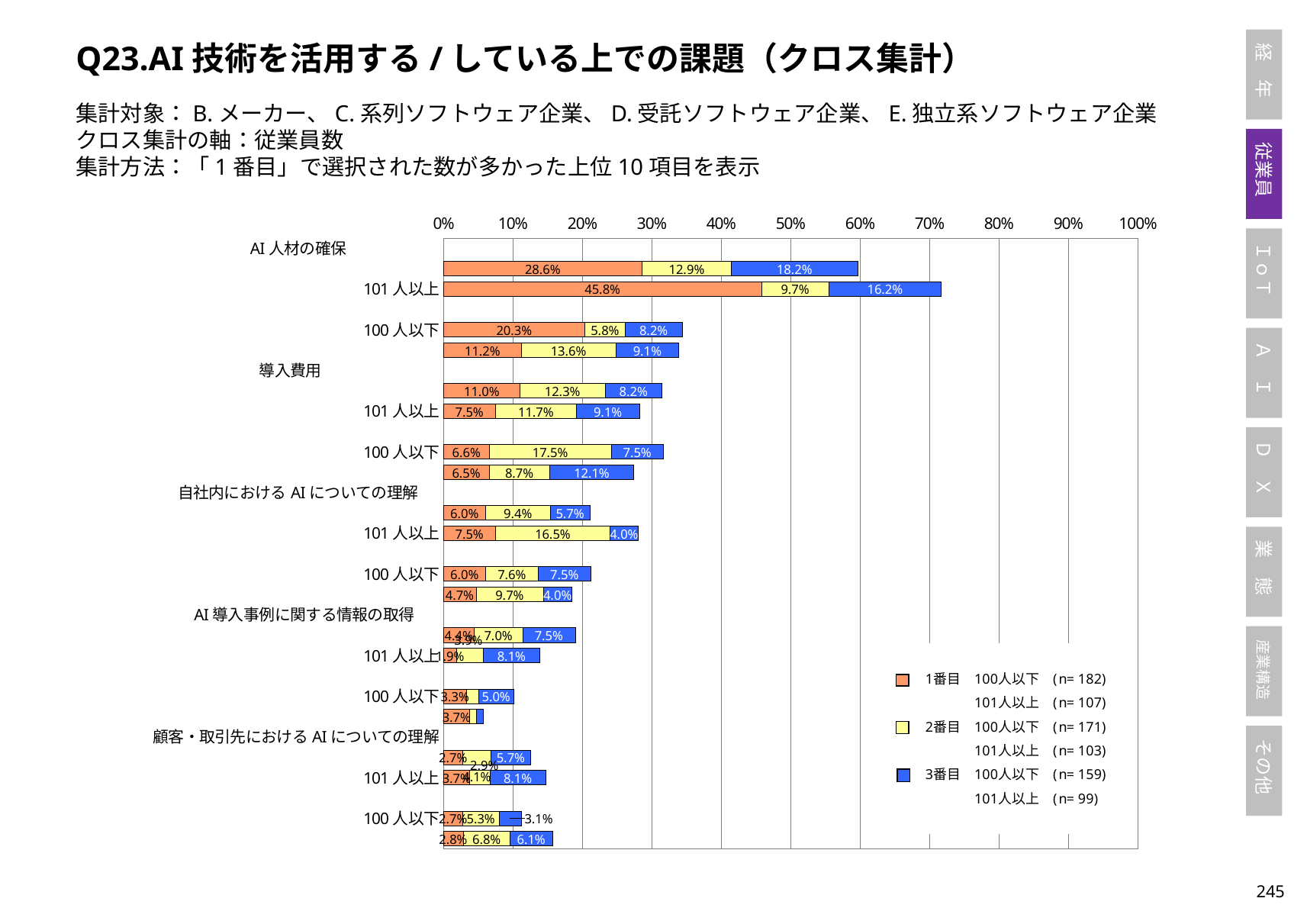
What is the largest single 1番目 (orange) segment value printed in the chart? 45.8% Which is larger: the 3番目 segment of 18.2% or the 3番目 segment of 16.2%? 18.2% According to the legend, what is the n for 1番目 100人以下? 182 How many series does the chart legend list (1番目, 2番目, 3番目)? 3 What is the total of the stacked bar with segments 45.8%, 9.7% and 16.2%? 71.7% In the bar whose 1番目 segment is 28.6%, what is the 2番目 (yellow) segment value? 12.9% What kind of chart is shown on the slide? bar chart What colour represents the 3番目 series in the legend? blue Is the total length of the longest stacked bar greater or less than 60%? greater What is the difference between the two largest 1番目 segment values, 45.8% and 28.6%? 17.2 percentage points In the bar whose 1番目 segment is 45.8%, what is the 3番目 (blue) segment value? 16.2% What is the total of the stacked bar with segments 28.6%, 12.9% and 18.2%? 59.7%